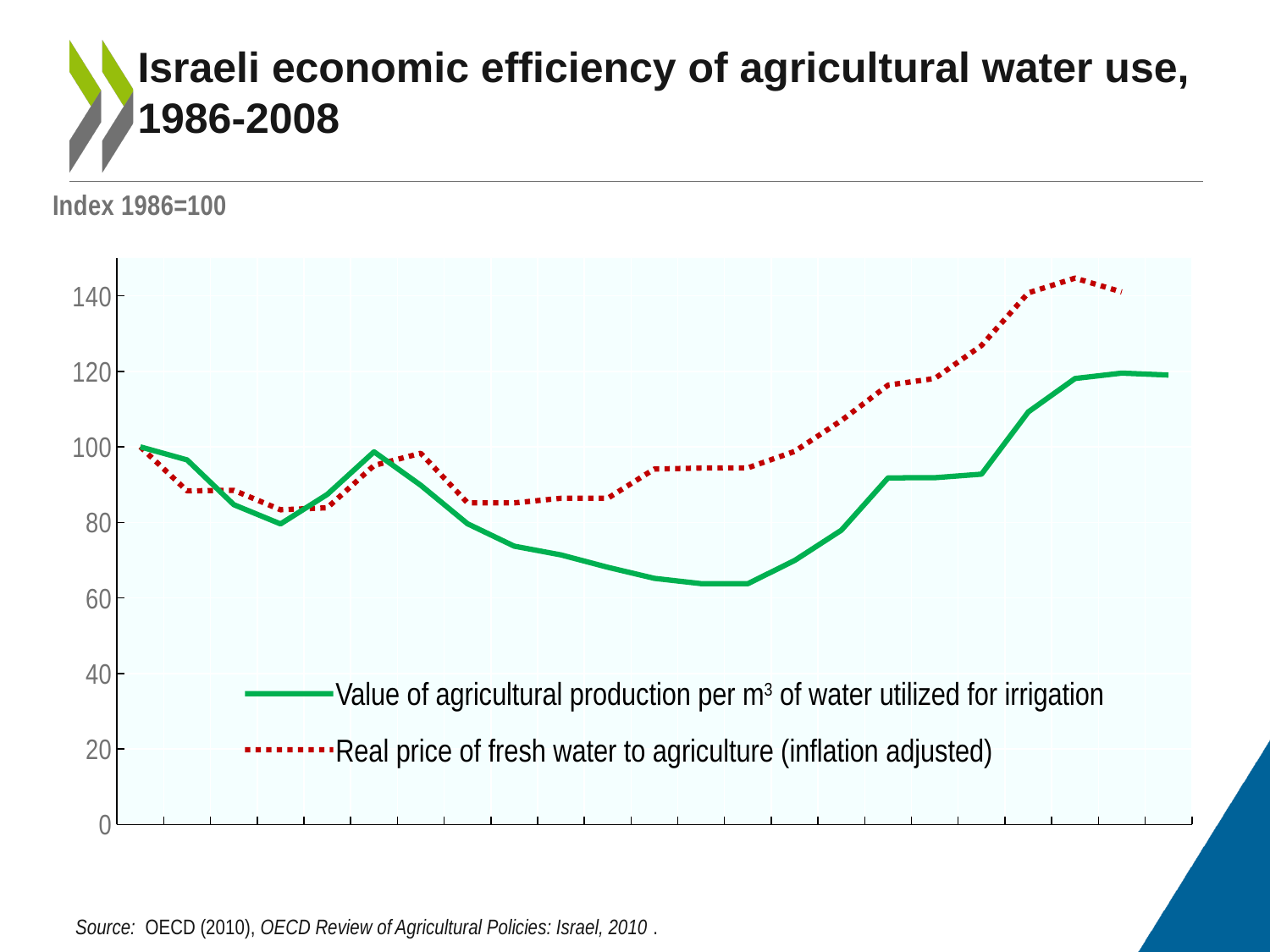
Is the lowest value of the 'Value of agricultural production per m³ of water utilized for irrigation' series greater or less than 60? greater Over the second half of the period, do both series rise or fall? rise What is the title of the chart on the slide? Israeli economic efficiency of agricultural water use, 1986-2008 What kind of chart is shown on the slide? line chart Comparing the start and end of the period, does the 'Real price of fresh water to agriculture (inflation adjusted)' series rise or fall overall? rise What is the index value of both series in the base year 1986? 100 How many series does the legend list? 2 Is the final value of the 'Value of agricultural production per m³ of water utilized for irrigation' series greater or less than 100? greater At the end of the period, which series is higher: the value of agricultural production per m³ of water or the real price of fresh water to agriculture? Real price of fresh water to agriculture (inflation adjusted) Which series is drawn as a red dotted line? Real price of fresh water to agriculture (inflation adjusted) Is the lowest value of the 'Value of agricultural production per m³ of water utilized for irrigation' series greater or less than 80? less